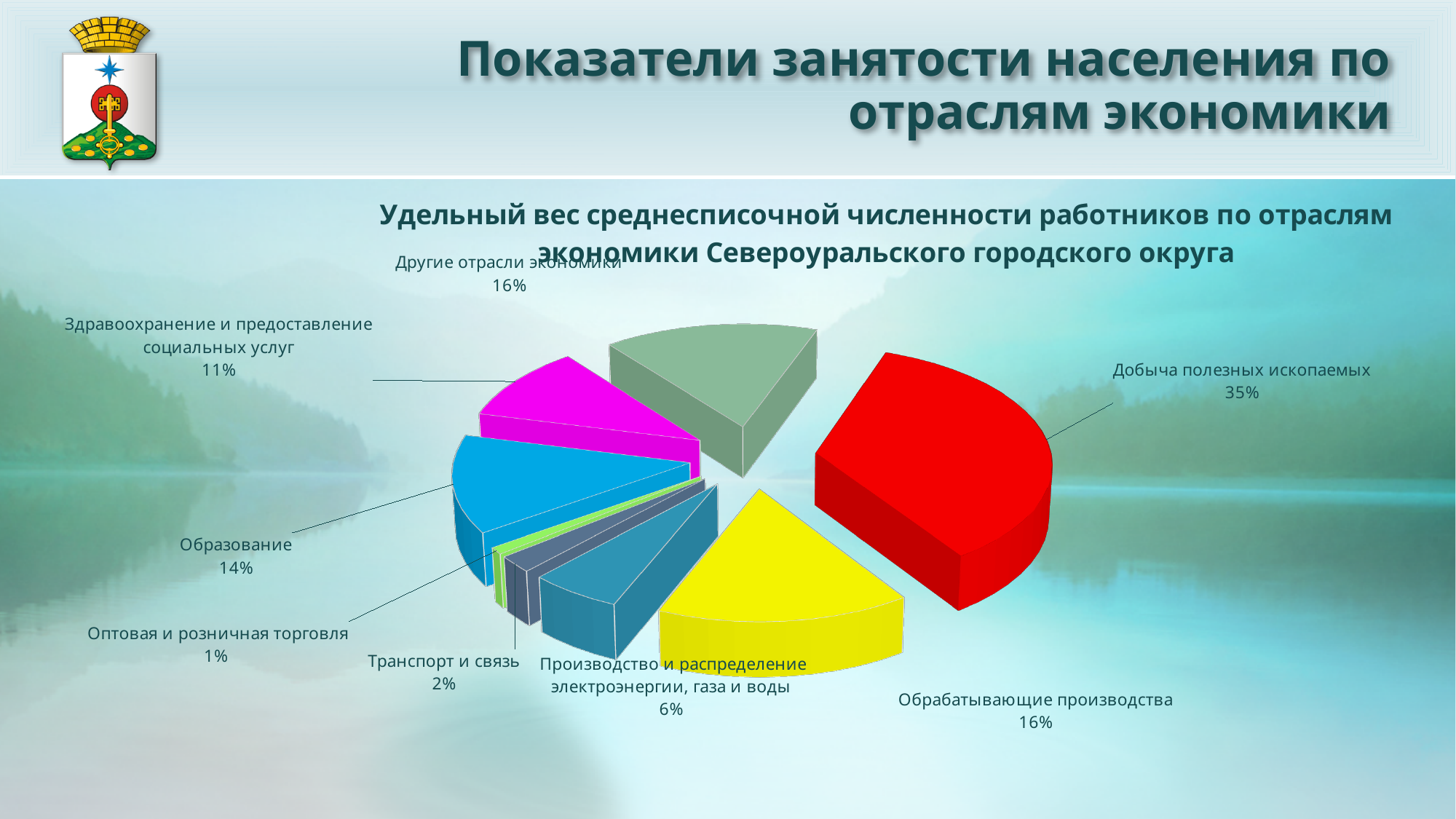
What share of workers is in Производство и распределение электроэнергии, газа и воды? 6% What share of workers is in Здравоохранение и предоставление социальных услуг? 11% Which sector has the smallest share of workers? Оптовая и розничная торговля What share of workers is in Добыча полезных ископаемых? 35% What colour is the slice for Добыча полезных ископаемых? Red What is the combined share of Транспорт и связь and Оптовая и розничная торговля? 3% Which has a larger share: Образование or Здравоохранение и предоставление социальных услуг? Образование What type of chart is shown on the slide? Pie chart How many sectors are shown in the pie chart? 8 What share of workers is in Образование? 14% What is the difference in percentage points between Добыча полезных ископаемых and Обрабатывающие производства? 19 Which sector has the largest share of workers? Добыча полезных ископаемых